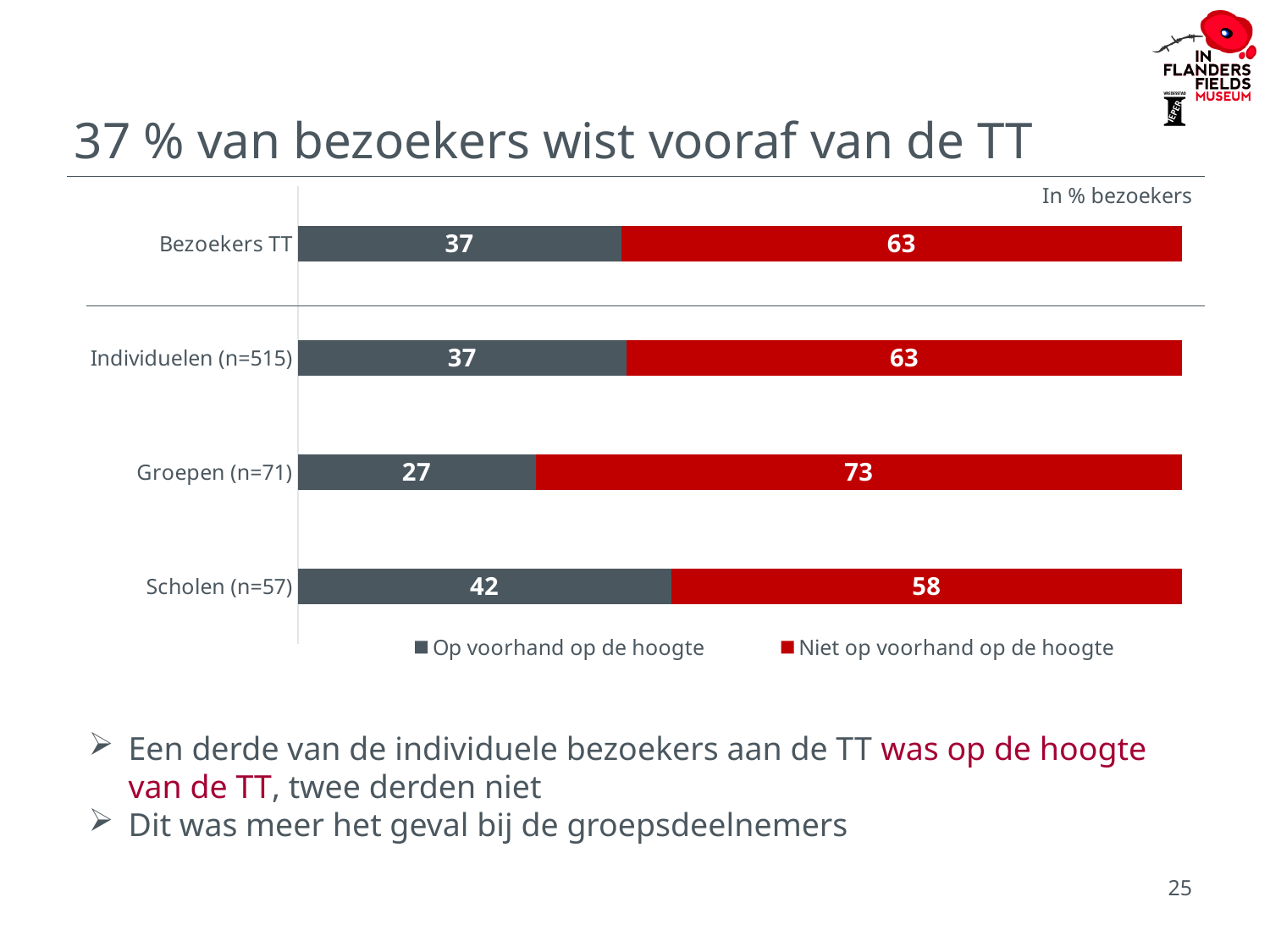
What is the difference between the "Niet op voorhand op de hoogte" values for Groepen (n=71) and Scholen (n=57)? 15 How many series does the legend list? 2 What is the value for "Op voorhand op de hoogte" for Groepen (n=71)? 27 Which category has the lowest value for "Op voorhand op de hoogte"? Groepen (n=71) What is the value for "Niet op voorhand op de hoogte" for Scholen (n=57)? 58 Which series is shown in red in the chart? Niet op voorhand op de hoogte What kind of chart is shown on the slide? Stacked bar chart What is the value for "Op voorhand op de hoogte" for Bezoekers TT? 37 What is the total of the stacked bar for Groepen (n=71)? 100 Which is larger: the "Op voorhand op de hoogte" value for Scholen (n=57) or for Individuelen (n=515)? Scholen (n=57) Which category has the highest value for "Op voorhand op de hoogte"? Scholen (n=57) How many categories are shown on the chart? 4